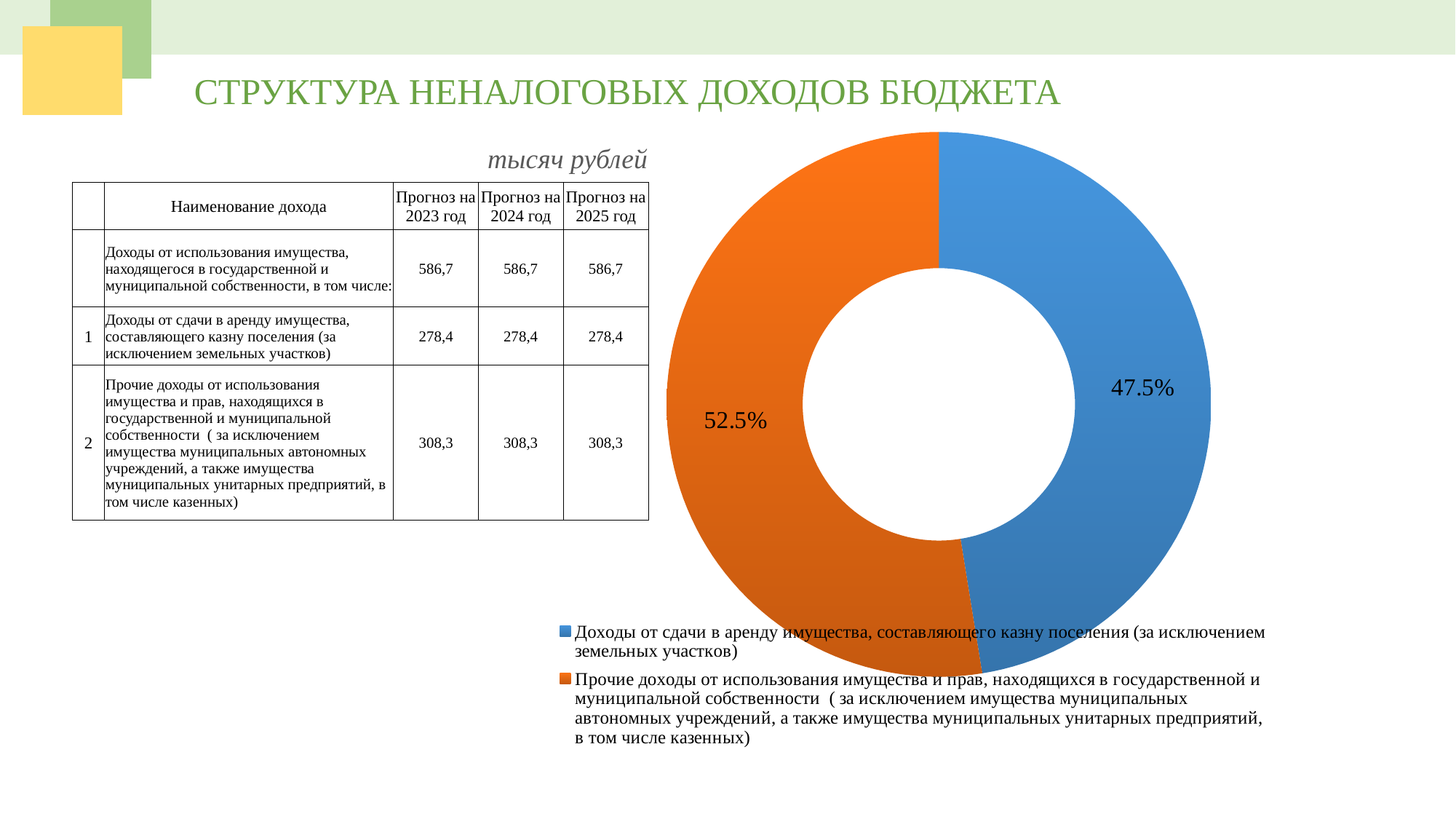
How many slices does the doughnut chart have? 2 What share of the doughnut chart is labelled for 'Прочие доходы от использования имущества и прав, находящихся в государственной и муниципальной собственности'? 52.5% Which is larger in the doughnut chart: the share for rental income from property in the settlement treasury or the share for other income from use of property and rights? Other income from use of property and rights (52.5%) What kind of chart is shown on the slide? Doughnut chart What share of the doughnut chart is labelled for 'Доходы от сдачи в аренду имущества, составляющего казну поселения (за исключением земельных участков)'? 47.5% What colour is the slice labelled 52.5% in the doughnut chart? Orange What is the difference in percentage points between the two slices of the doughnut chart? 5 percentage points What is the title of the slide containing the doughnut chart? СТРУКТУРА НЕНАЛОГОВЫХ ДОХОДОВ БЮДЖЕТА Is the share for 'Доходы от сдачи в аренду имущества' in the doughnut chart greater or less than 50%? less Which slice of the doughnut chart is the largest? Прочие доходы от использования имущества и прав, находящихся в государственной и муниципальной собственности Which slice of the doughnut chart is the smallest? Доходы от сдачи в аренду имущества, составляющего казну поселения (за исключением земельных участков) How many entries does the chart legend list? 2